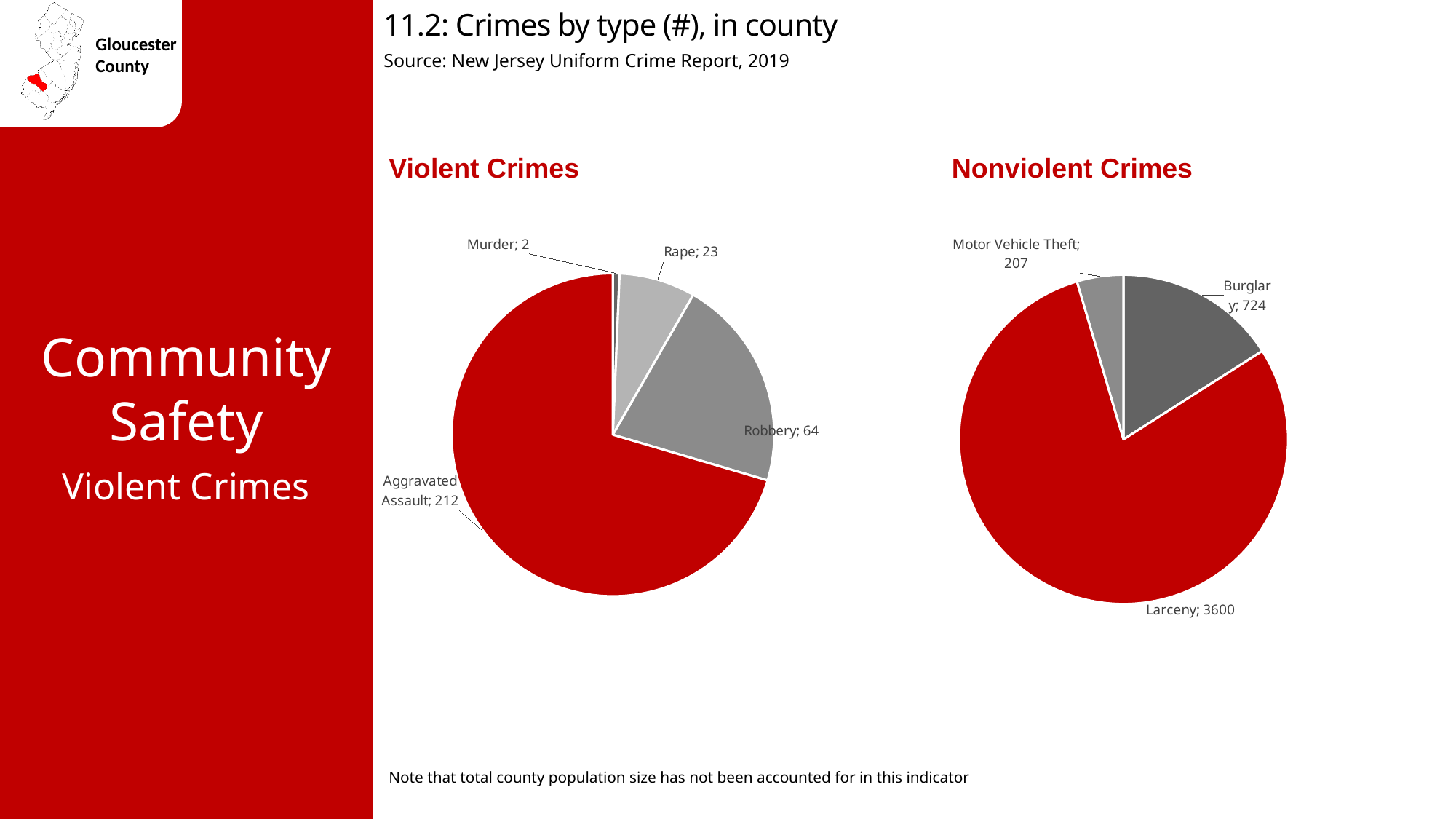
What is the total of all categories in the Violent Crimes pie chart? 301 In the Violent Crimes pie chart, how many robberies are shown? 64 In the Violent Crimes pie chart, which is larger, Rape or Robbery? Robbery In the Violent Crimes pie chart, which category has the smallest slice? Murder In the Nonviolent Crimes pie chart, which category has the smallest value? Motor Vehicle Theft How many categories are shown in the Violent Crimes pie chart? 4 How many categories are shown in the Nonviolent Crimes pie chart? 3 In the Violent Crimes pie chart, which category has the largest slice? Aggravated Assault In the Violent Crimes pie chart, what is the difference between Robbery and Rape? 41 In the Nonviolent Crimes pie chart, what is the value for Burglary? 724 In the Nonviolent Crimes pie chart, what is the difference between Larceny and Burglary? 2876 What type of chart is used for Nonviolent Crimes? Pie chart